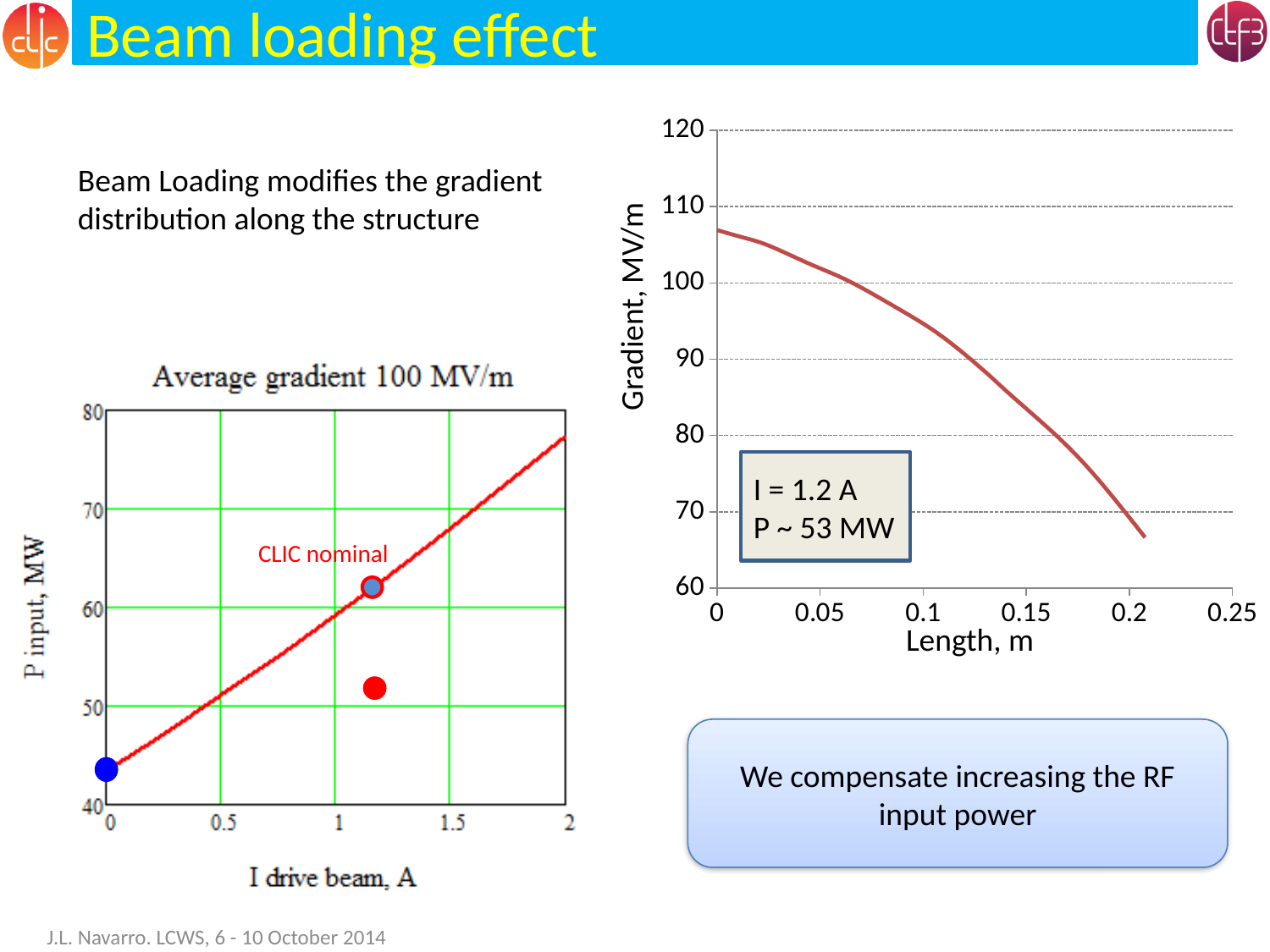
What is the title of the chart on the left? Average gradient 100 MV/m What drive beam current is stated in the annotation box on the right chart? I = 1.2 A What type of chart is the chart on the right (Gradient vs Length)? line chart In the chart on the left, does P input rise or fall as I drive beam increases? rise In the chart on the left, is the P input of the red dot below the line greater or less than 60 MW? less In the chart on the left, is the P input of the CLIC nominal point greater or less than 60 MW? greater What is the y-axis label of the chart on the right? Gradient, MV/m In the chart on the right, is the gradient at length 0.15 m greater or less than 90 MV/m? less In the chart on the right, does the gradient rise or fall as length increases? fall